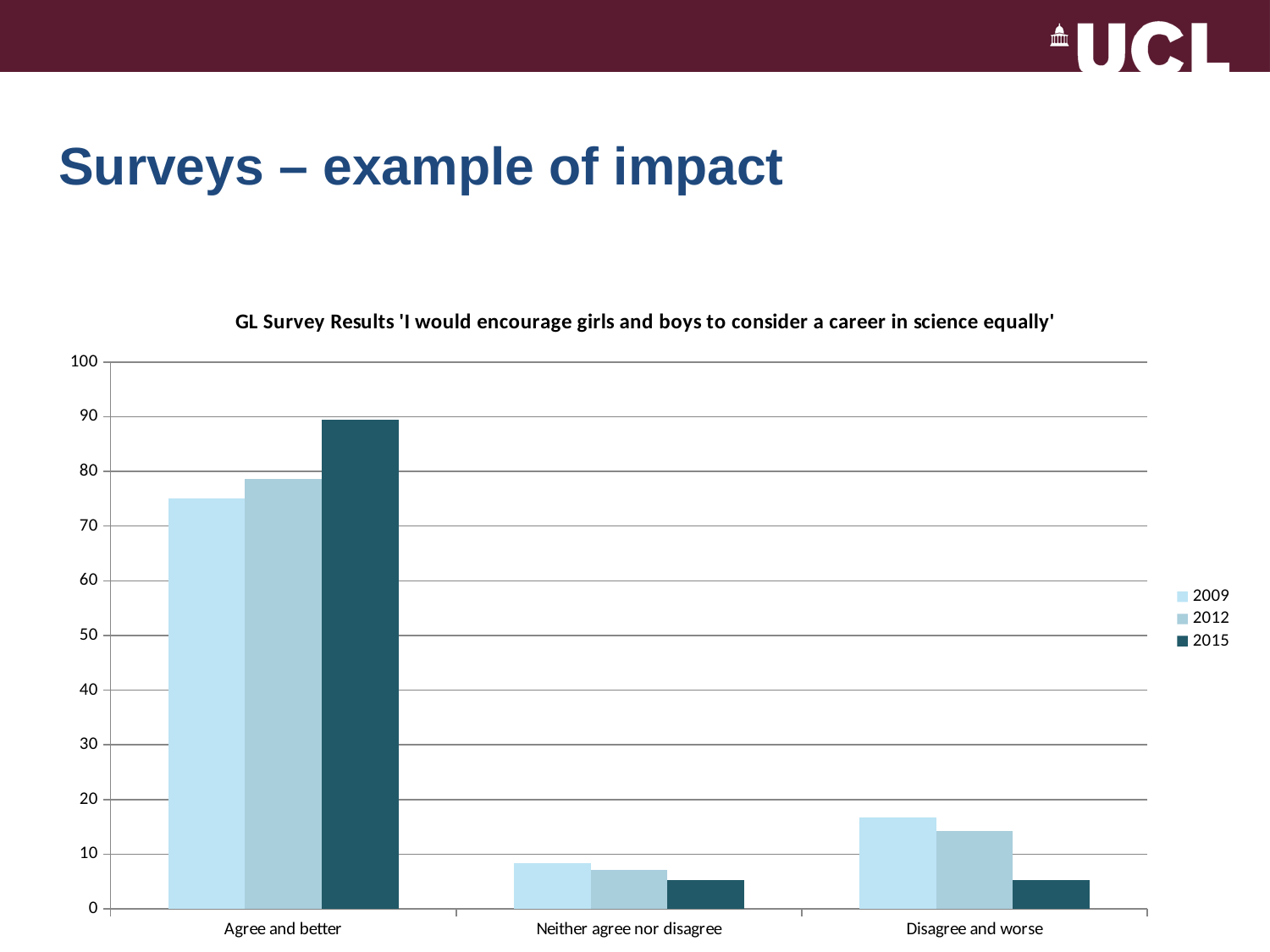
Which is larger for 'Disagree and worse': the 2009 value or the 2012 value? 2009 What kind of chart is shown on the slide? Bar chart Which year has the tallest bar in the 'Disagree and worse' category? 2009 Which year has the shortest bar in the 'Agree and better' category? 2009 Do the values for 'Agree and better' rise or fall from 2009 to 2015? rise Is the 2015 value for 'Disagree and worse' greater or less than 10? less How many series does the legend list? 3 Which year has the tallest bar in the 'Agree and better' category? 2015 Is the 2009 value for 'Disagree and worse' greater or less than 10? greater Is the 2015 value for 'Agree and better' greater or less than 80? greater How many categories are shown on the x axis? 3